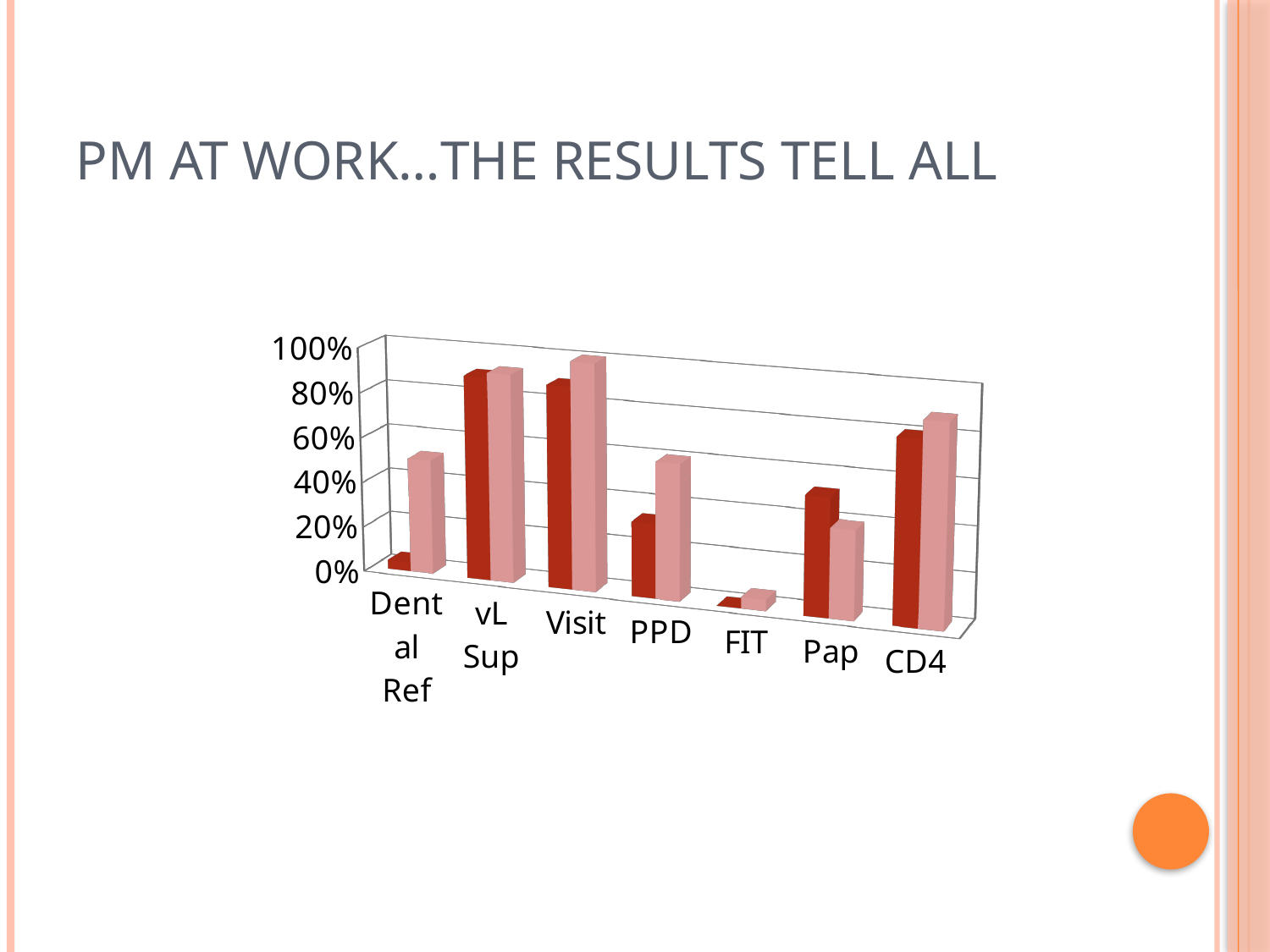
Is the dark red bar for Dental Ref greater or less than 20%? less Is the pink bar for CD4 greater or less than 40%? greater What kind of chart is shown on the slide? bar chart For Dental Ref, which bar is taller, the dark red bar or the pink bar? the pink bar Is the pink bar for FIT greater or less than 20%? less For Pap, which bar is taller, the dark red bar or the pink bar? the dark red bar How many categories are shown on the x axis of the chart? 7 How many bars (series) are plotted for each category in the chart? 2 Which category has the lowest dark red bar? FIT What is the title of the slide containing the chart? PM AT WORK...THE RESULTS TELL ALL